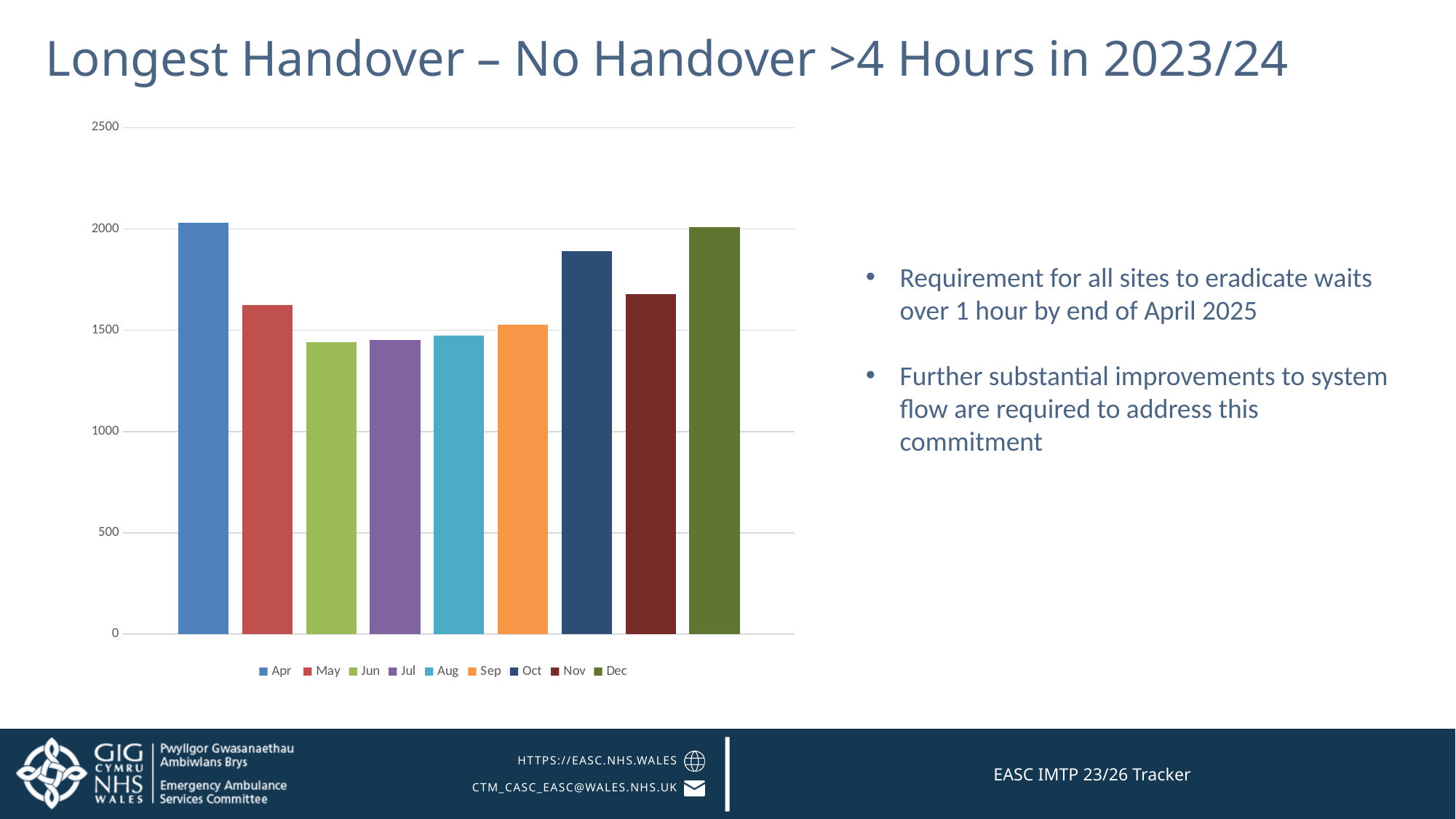
Is the value for Nov greater or less than 1500? greater Is the value for Apr greater or less than 2000? greater Is the value for Oct greater or less than 2000? less How many entries does the chart legend list? 9 What is the title of the slide containing the chart? Longest Handover – No Handover >4 Hours in 2023/24 Do the values rise or fall from Apr to Jun? fall Which is larger, the value for Oct or the value for Nov? Oct What kind of chart is shown on the slide? bar chart How many bars are plotted in the chart? 9 Which is larger, the value for May or the value for Jun? May Do the values rise or fall from Jun to Dec? rise